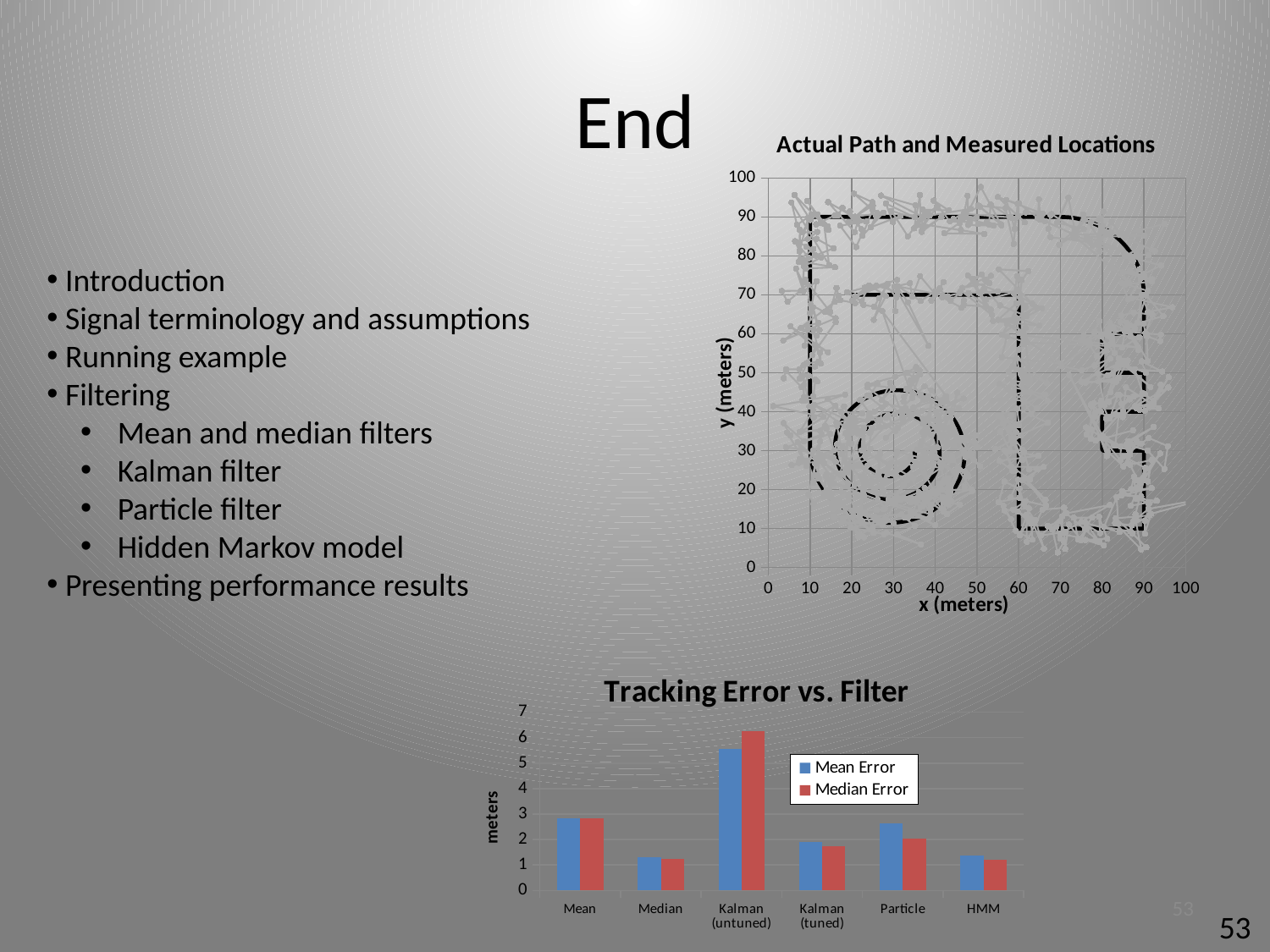
In the 'Tracking Error vs. Filter' chart, how many series does the legend list? 2 In the 'Tracking Error vs. Filter' chart, which filter has the highest Median Error? Kalman (untuned) In the 'Tracking Error vs. Filter' chart, which filter has the highest Mean Error? Kalman (untuned) In the 'Tracking Error vs. Filter' chart, how many filter categories are shown on the x axis? 6 In the 'Tracking Error vs. Filter' chart, is the Median Error for Kalman (untuned) greater or less than 6? greater In the 'Tracking Error vs. Filter' chart, for Kalman (untuned), which is larger: the Mean Error or the Median Error? Median Error In the 'Tracking Error vs. Filter' chart, what is the label on the vertical axis? meters In the 'Tracking Error vs. Filter' chart, what kind of chart is shown? bar chart In the 'Tracking Error vs. Filter' chart, is the Mean Error for Median greater or less than 2? less In the 'Tracking Error vs. Filter' chart, for Particle, which is larger: the Mean Error or the Median Error? Mean Error In the 'Actual Path and Measured Locations' chart, what is the label on the horizontal axis? x (meters) In the 'Tracking Error vs. Filter' chart, is the Mean Error for Mean greater or less than 3? less